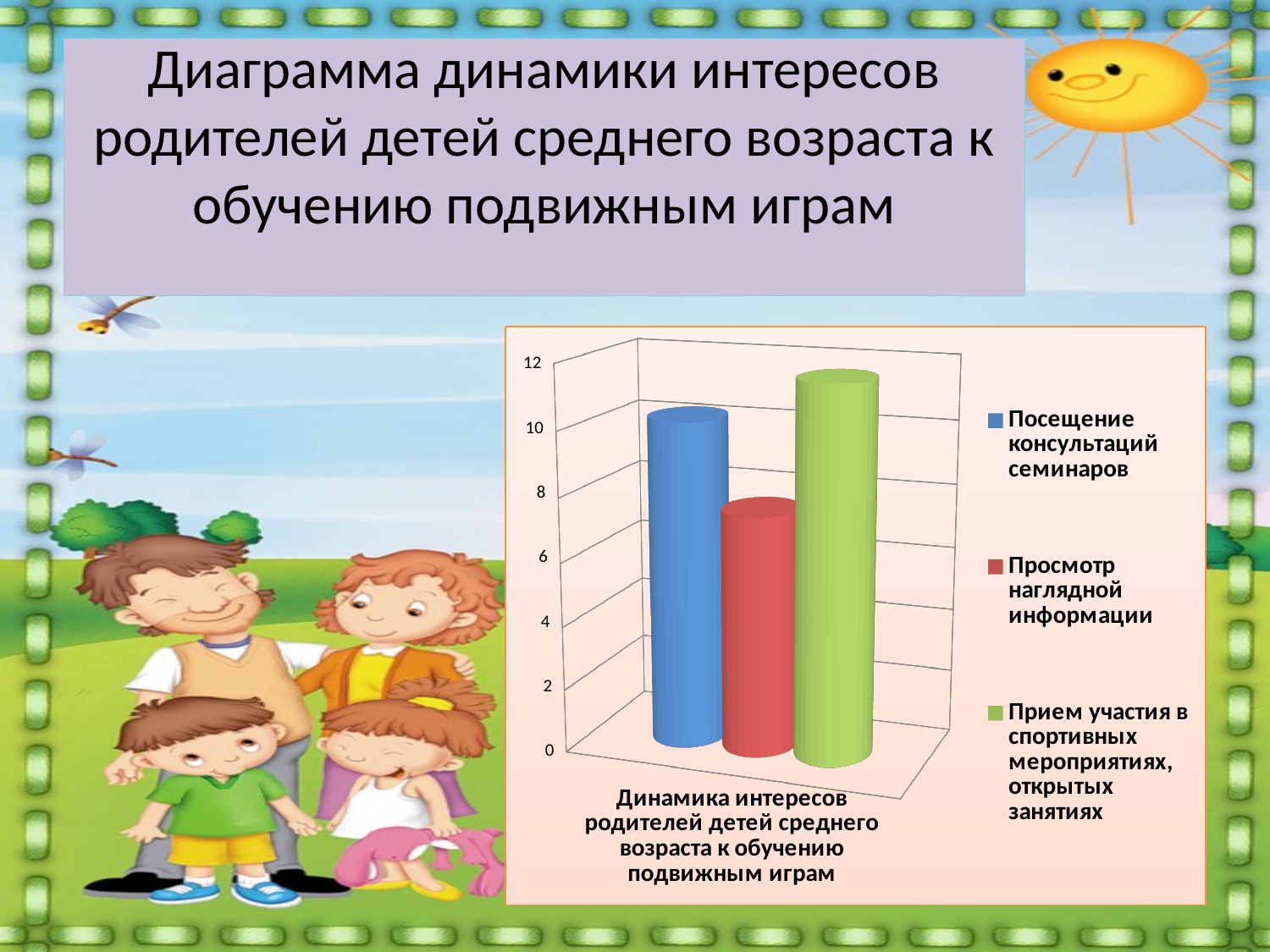
Is the value for Просмотр наглядной информации greater or less than 10? less How many categories are shown on the x axis? 1 Is the value for Посещение консультаций семинаров greater or less than 6? greater Which series has the highest value? Прием участия в спортивных мероприятиях, открытых занятиях Which is larger: the value for Посещение консультаций семинаров or the value for Просмотр наглядной информации? Посещение консультаций семинаров Which series has the lowest value? Просмотр наглядной информации How many series does the legend list? 3 What colour is the bar for Просмотр наглядной информации? red What is the maximum value shown on the vertical axis? 12 Which is larger: the value for Прием участия в спортивных мероприятиях, открытых занятиях or the value for Посещение консультаций семинаров? Прием участия в спортивных мероприятиях, открытых занятиях What kind of chart is shown on the slide? bar chart Is the value for Прием участия в спортивных мероприятиях, открытых занятиях greater or less than 8? greater